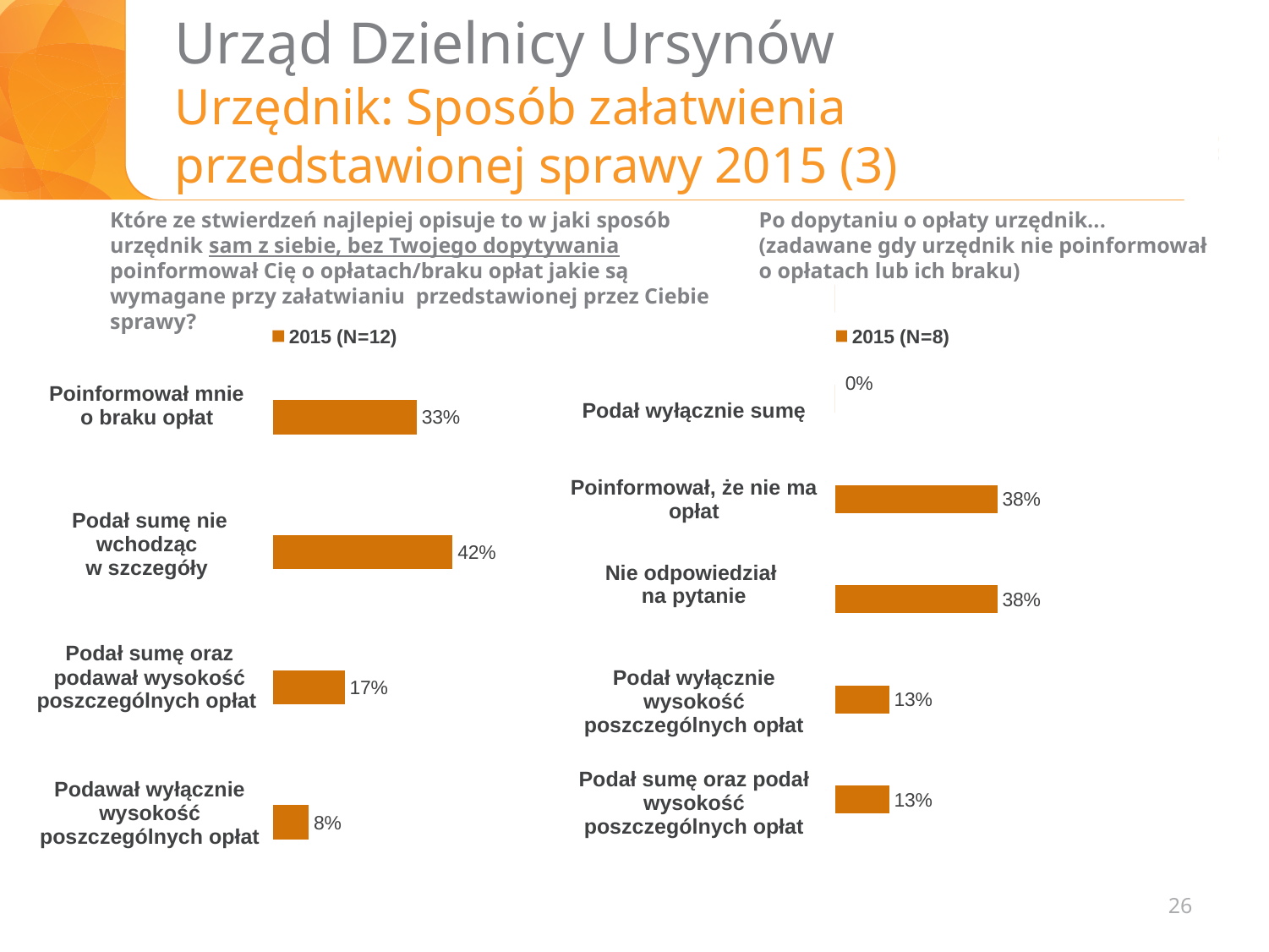
In the left chart (2015, N=12), which category has the lowest value? Podawał wyłącznie wysokość poszczególnych opłat What type of chart is the left chart (2015, N=12)? Bar chart In the left chart (2015, N=12), what is the difference between "Podał sumę nie wchodząc w szczegóły" and "Poinformował mnie o braku opłat"? 9 percentage points In the right chart (2015, N=8), how many categories are shown? 5 In the left chart (2015, N=12), how many categories are shown? 4 In the left chart (2015, N=12), which category has the highest value? Podał sumę nie wchodząc w szczegóły In the right chart (2015, N=8), what is the value for "Podał wyłącznie sumę"? 0% In the right chart (2015, N=8), what is the value for "Poinformował, że nie ma opłat"? 38% In the right chart (2015, N=8), which is larger: "Nie odpowiedział na pytanie" or "Podał wyłącznie wysokość poszczególnych opłat"? Nie odpowiedział na pytanie In the right chart (2015, N=8), which category has the lowest value? Podał wyłącznie sumę In the left chart (2015, N=12), what is the value for "Podawał wyłącznie wysokość poszczególnych opłat"? 8% In the left chart (2015, N=12), what is the value for "Podał sumę nie wchodząc w szczegóły"? 42%